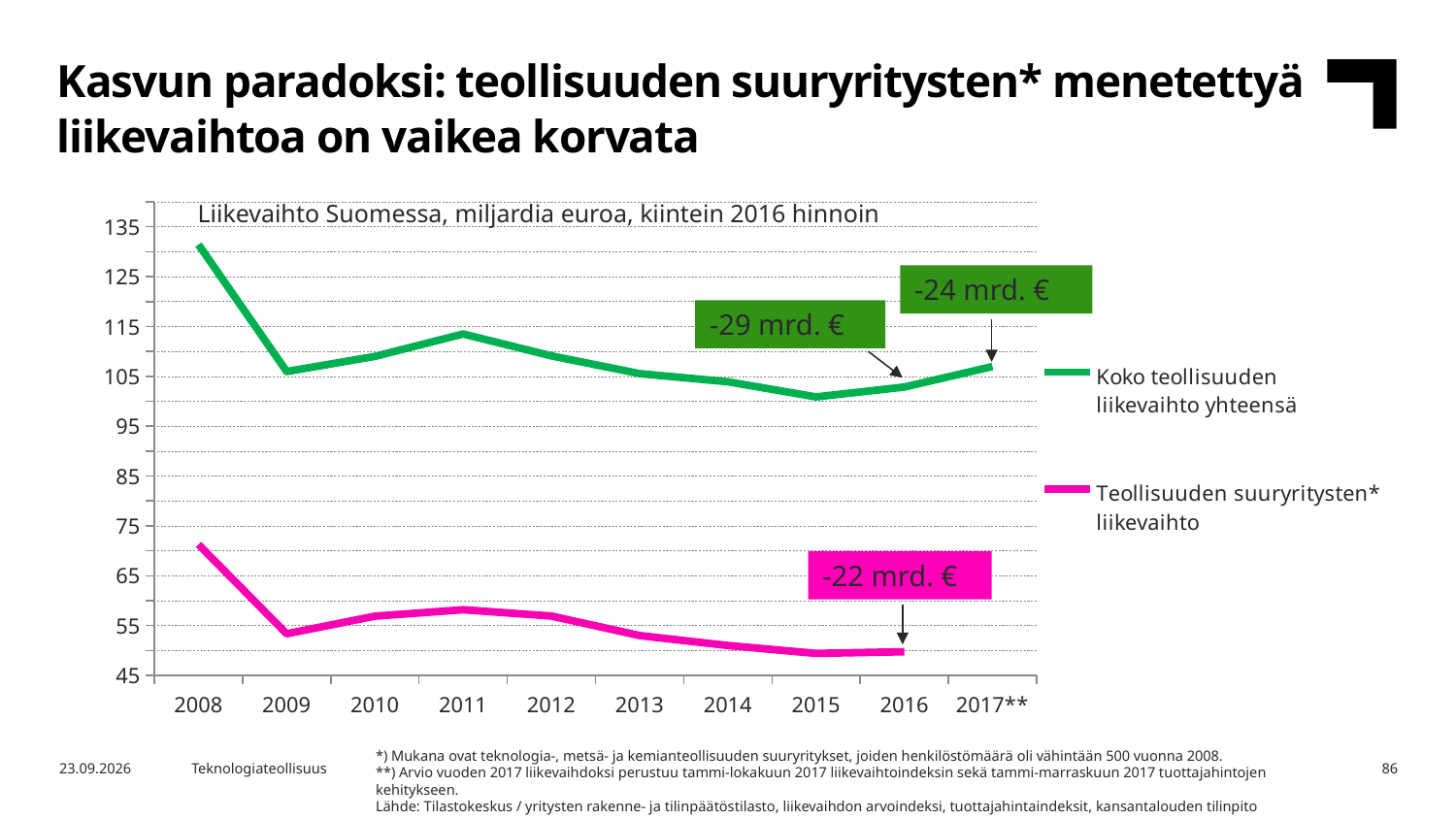
What value is annotated for the Teollisuuden suuryritysten* liikevaihto series at 2016? -22 mrd. € Does the Koko teollisuuden liikevaihto yhteensä series rise or fall from 2008 to 2009? fall How many series does the legend list? 2 Is the value for Koko teollisuuden liikevaihto yhteensä in 2008 greater or less than 125? greater What value is annotated for the Koko teollisuuden liikevaihto yhteensä series at 2016? -29 mrd. € Is the value for Teollisuuden suuryritysten* liikevaihto in 2015 greater or less than 55? less What value is annotated for the Koko teollisuuden liikevaihto yhteensä series at 2017**? -24 mrd. € What kind of chart is shown on the slide? line chart In which year is the Teollisuuden suuryritysten* liikevaihto series at its highest? 2008 How many years are shown on the x axis? 10 In which year is the Koko teollisuuden liikevaihto yhteensä series at its highest? 2008 What is the title of the chart? Liikevaihto Suomessa, miljardia euroa, kiintein 2016 hinnoin